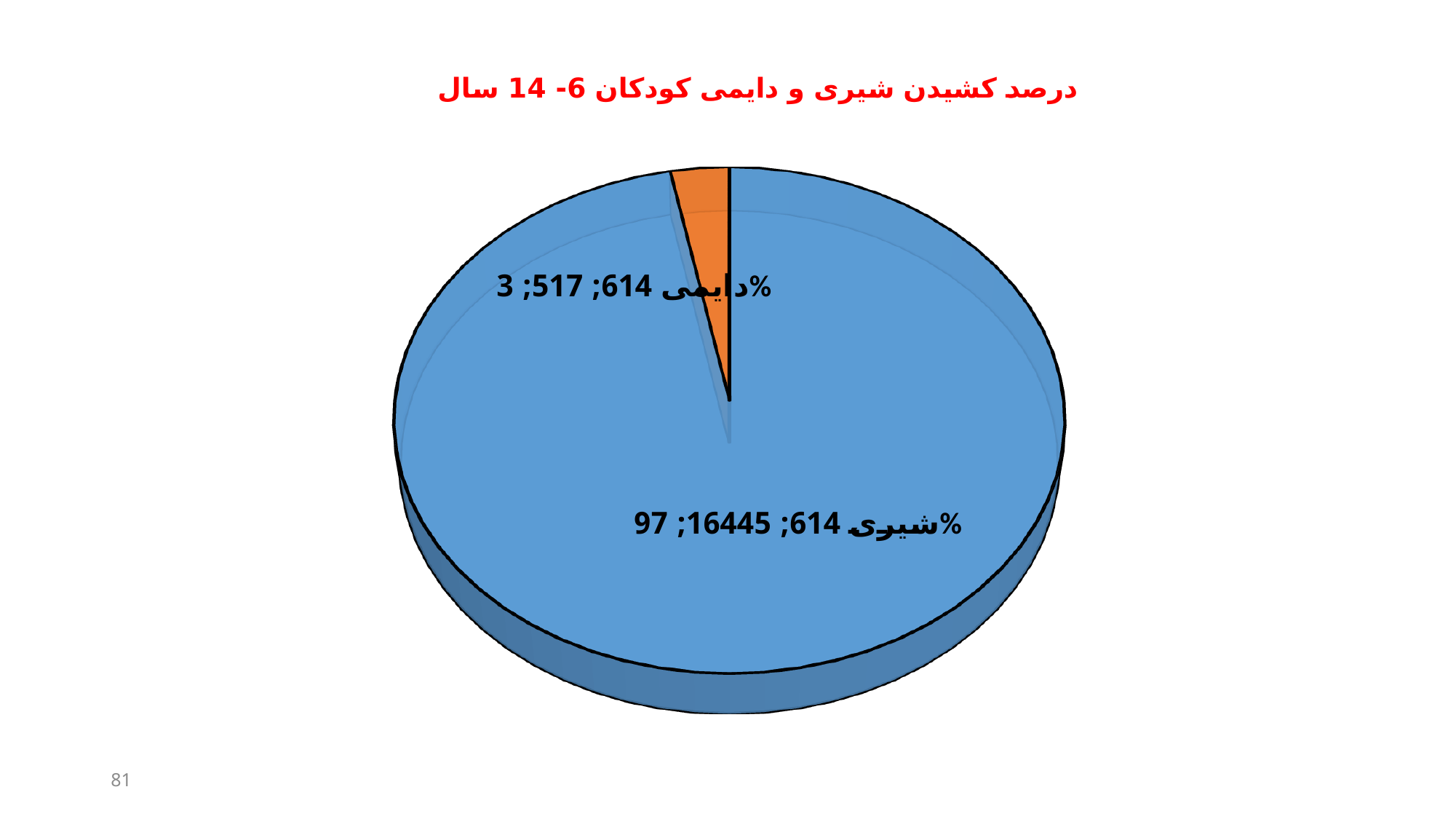
Which is larger, the value for شیری or the value for دایمی? شیری What is the difference between the values for شیری and دایمی? 15928 Which slice is the largest in the pie chart? شیری What percentage share of the pie does the شیری slice have? 97% Which slice is the smallest in the pie chart? دایمی What is the title of the chart? درصد کشیدن شیری و دایمی کودکان 6- 14 سال What percentage share of the pie does the دایمی slice have? 3% What kind of chart is shown on the slide? pie chart What colour is the دایمی slice? orange What value is shown for the دایمی slice? 517 What value is shown for the شیری slice? 16445 How many slices does the pie chart have? 2